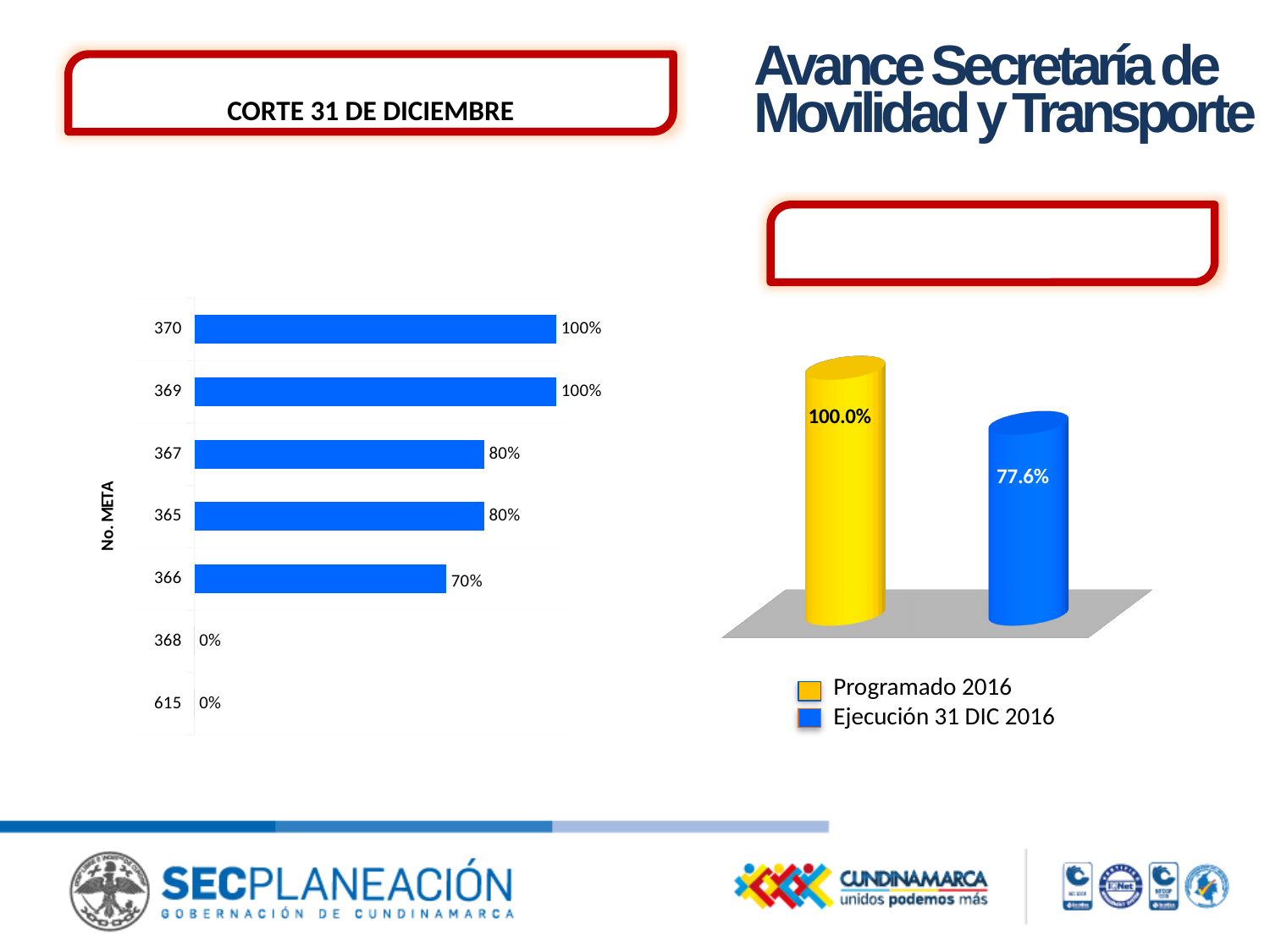
In the left bar chart, how many metas (categories) are shown? 7 In the left bar chart, which is larger, the value for meta 365 or the value for meta 366? 365 In the left bar chart, what is the value for meta 615? 0% In the left bar chart, which meta has the lowest value, 367 or 368? 368 In the right chart, how many entries does the legend list? 2 What kind of chart is the left chart? bar chart In the right chart, what is the difference between Programado 2016 and Ejecución 31 DIC 2016? 22.4% In the left bar chart, what is the value for meta 367? 80% In the left bar chart, what is the difference between the values for meta 369 and meta 366? 30% In the left bar chart, what is the value for meta 366? 70% In the right chart, what is the value for Programado 2016? 100.0% In the right chart, what is the value for Ejecución 31 DIC 2016? 77.6%